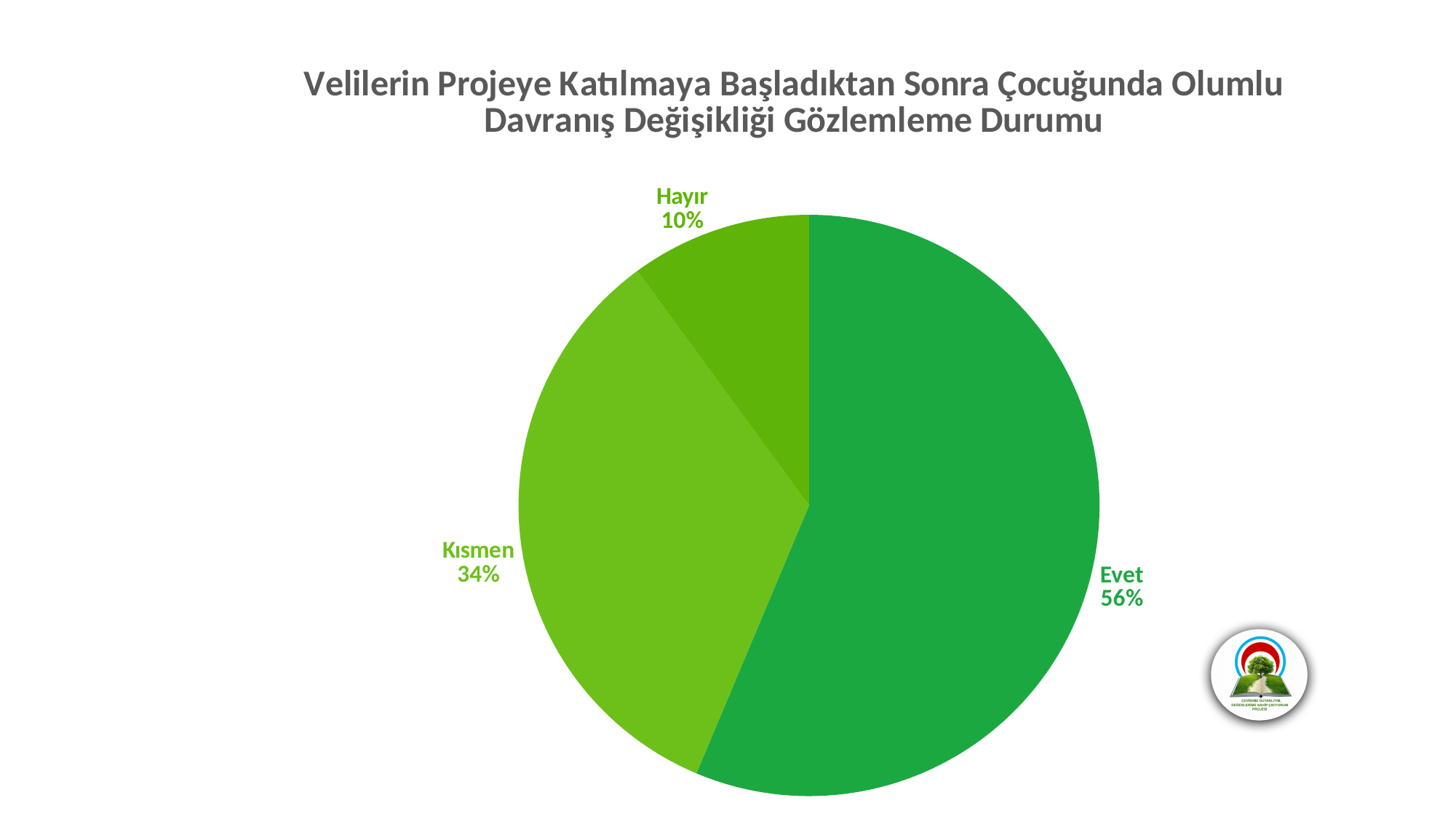
What is the combined share of the Kısmen and Hayır slices? 44% What percentage of the pie is labelled Evet? 56% What percentage of the pie is labelled Kısmen? 34% What is the difference in percentage points between the Evet and Kısmen slices? 22 Which slice of the pie is the largest? Evet What type of chart is shown on the slide? Pie chart How many slices does the pie chart have? 3 What percentage of the pie is labelled Hayır? 10% What is the difference in percentage points between the Kısmen and Hayır slices? 24 Which is larger, the Kısmen slice or the Hayır slice? Kısmen What is the title of the chart? Velilerin Projeye Katılmaya Başladıktan Sonra Çocuğunda Olumlu Davranış Değişikliği Gözlemleme Durumu Which slice of the pie is the smallest? Hayır